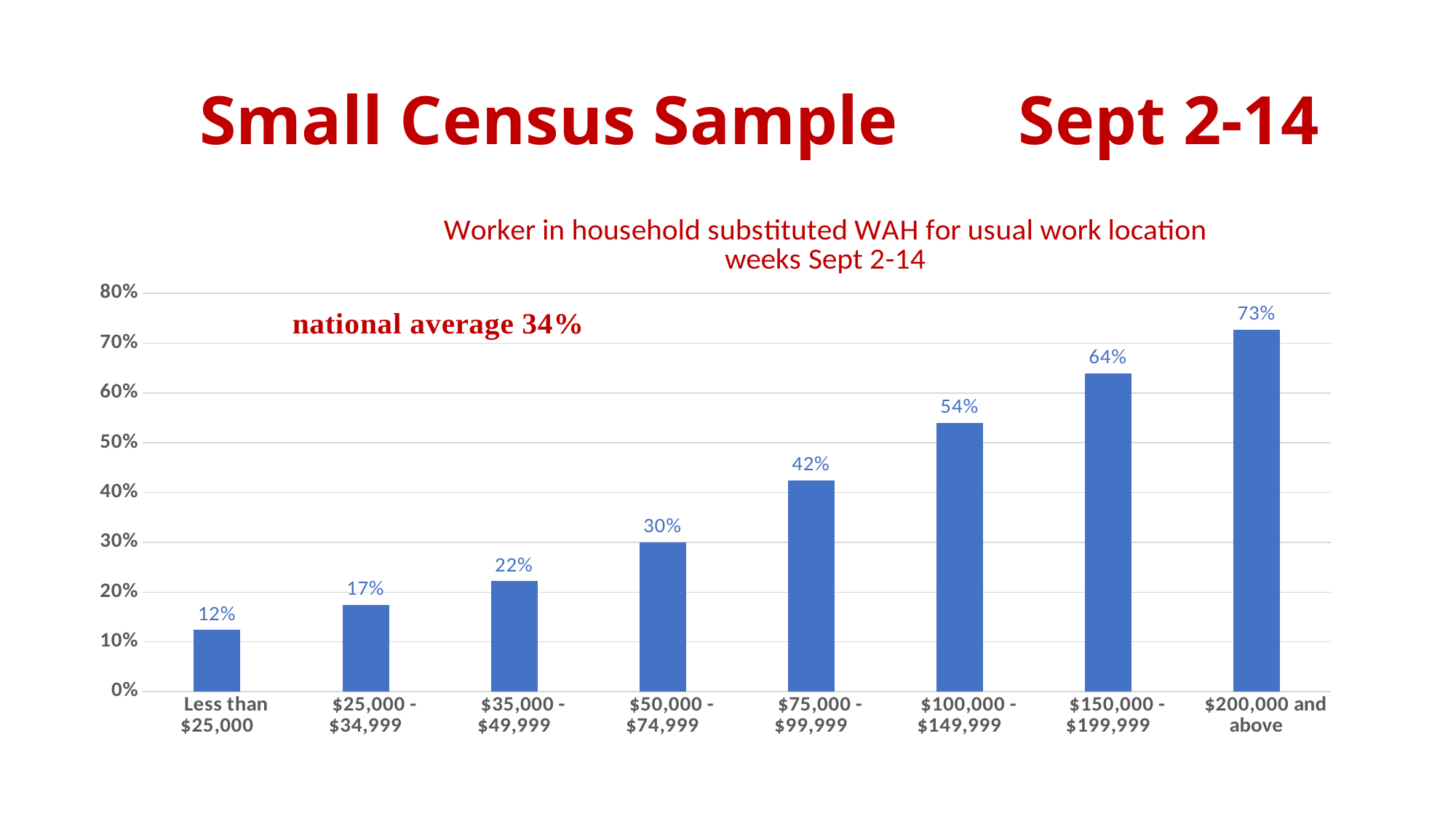
Is the value for $100,000 - $149,999 greater or less than 50%? greater Which income group has the lowest value? Less than $25,000 How many income groups are shown on the chart? 8 What is the difference between the values for $200,000 and above and $100,000 - $149,999? 19% What kind of chart is shown on the slide? bar chart What national average is noted on the chart? 34% Which is larger, the value for $35,000 - $49,999 or the value for $75,000 - $99,999? $75,000 - $99,999 What is the value for the $50,000 - $74,999 income group? 30% What is the value for the $150,000 - $199,999 income group? 64% Do the values rise or fall as income increases along the x axis? rise Which income group has the highest value? $200,000 and above What is the value for the Less than $25,000 income group? 12%